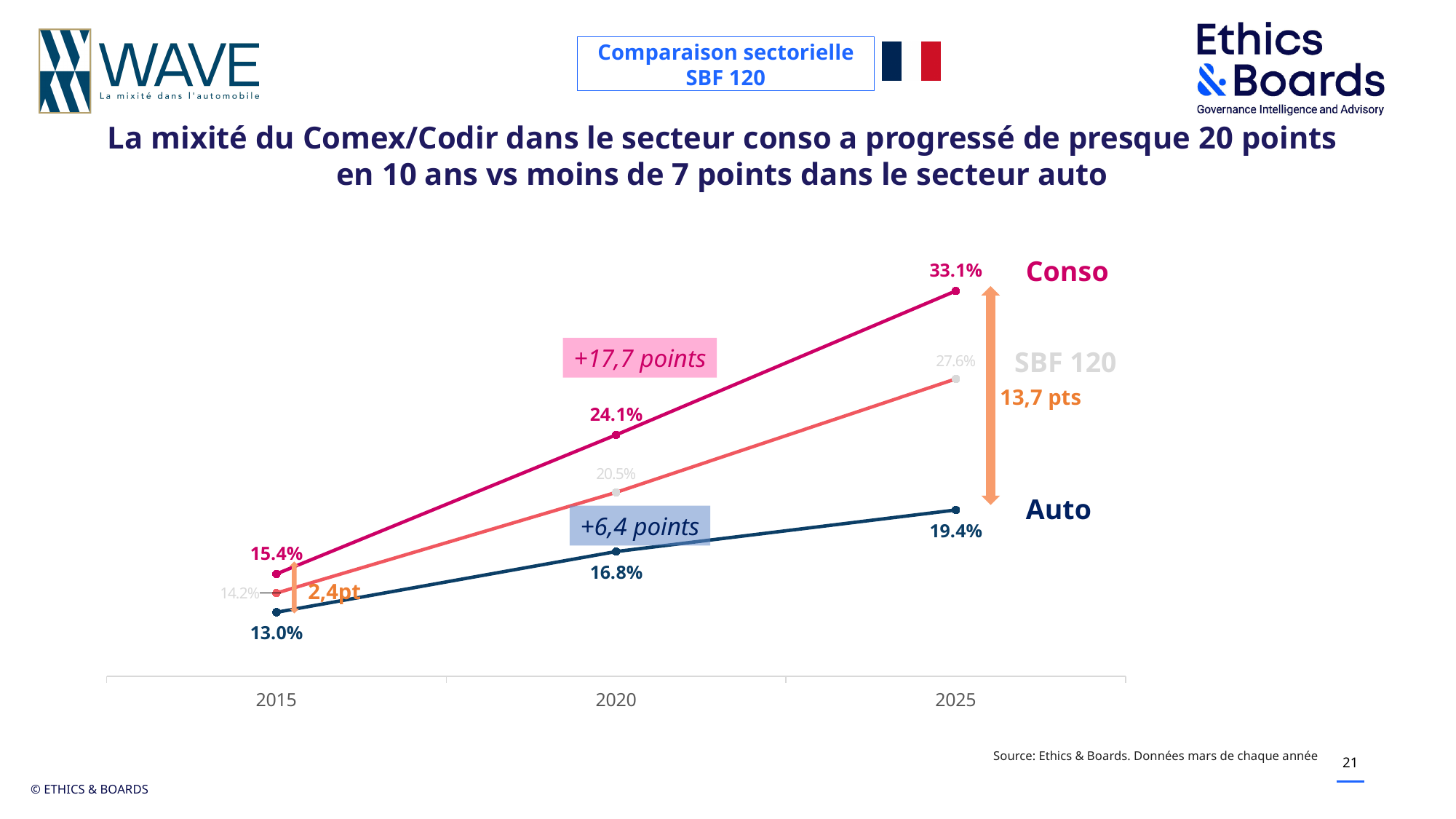
Does the Auto series rise or fall from 2015 to 2025? rise Which series has the highest value in 2025? Conso What is the value for SBF 120 in 2020? 20.5% What is the value for Auto in 2020? 16.8% What type of chart is shown on the slide? line chart How many years are shown on the x axis? 3 Which series has the lowest value in 2015? Auto What is the difference between the Conso and Auto values in 2025? 13.7 points What is the value for Auto in 2015? 13.0% Which is larger in 2020, the SBF 120 value or the Auto value? SBF 120 What is the value for Conso in 2025? 33.1% How many series are plotted on the chart? 3